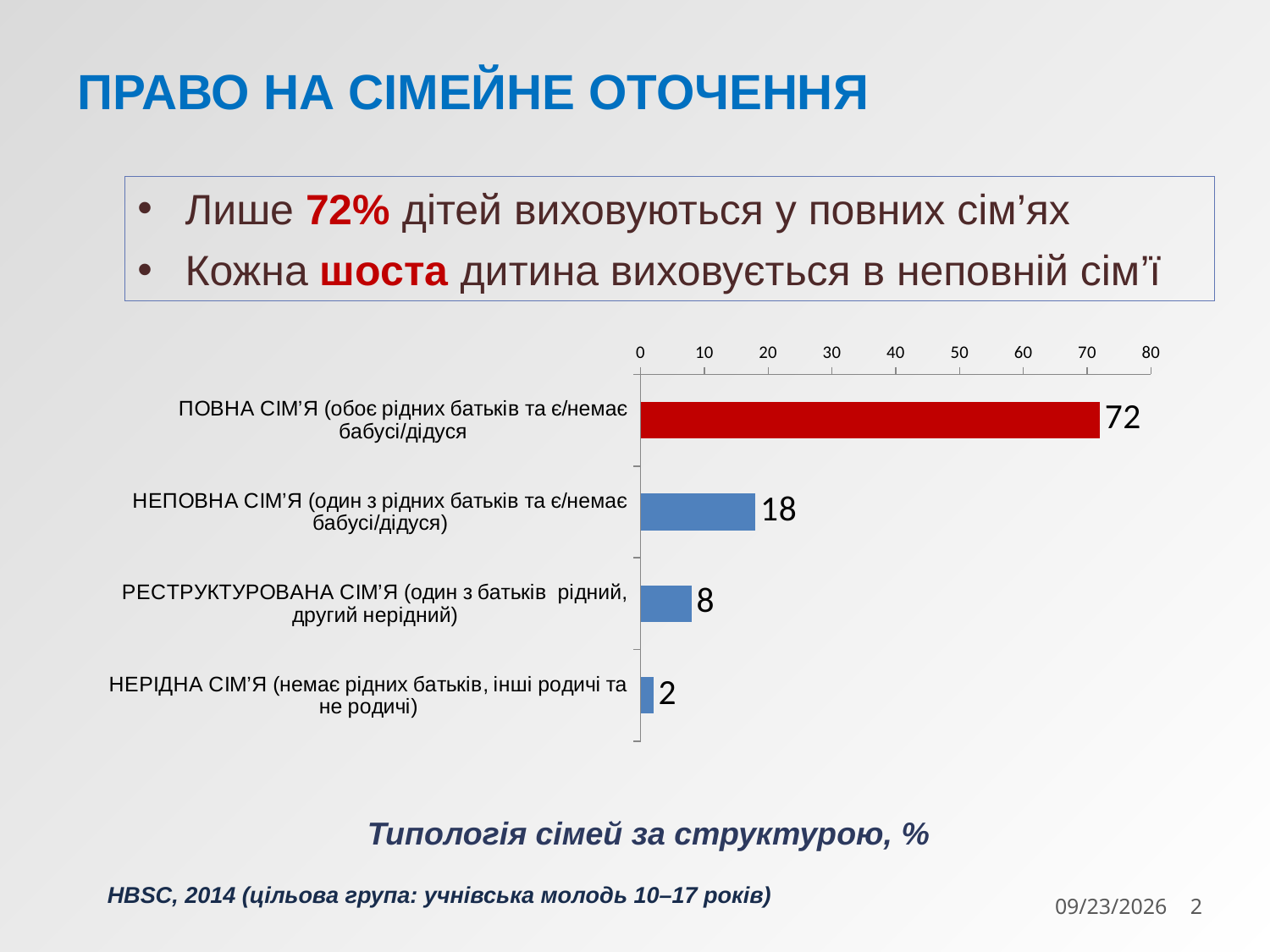
What is the difference between the values for ПОВНА СІМ'Я and НЕПОВНА СІМ'Я? 54 Which category has the highest value? ПОВНА СІМ'Я What is the value for НЕРІДНА СІМ'Я (немає рідних батьків, інші родичі та не родичі)? 2 What kind of chart is shown on the slide? bar chart What is the value for НЕПОВНА СІМ'Я (один з рідних батьків та є/немає бабусі/дідуся)? 18 Which is larger, the value for РЕСТРУКТУРОВАНА СІМ'Я or the value for НЕРІДНА СІМ'Я? РЕСТРУКТУРОВАНА СІМ'Я What is the value for РЕСТРУКТУРОВАНА СІМ'Я (один з батьків рідний, другий нерідний)? 8 Which category has the lowest value? НЕРІДНА СІМ'Я Is the value for НЕПОВНА СІМ'Я greater or less than 20? less What is the caption of the chart? Типологія сімей за структурою, % What is the value for ПОВНА СІМ'Я (обоє рідних батьків та є/немає бабусі/дідуся)? 72 How many categories are shown in the chart? 4